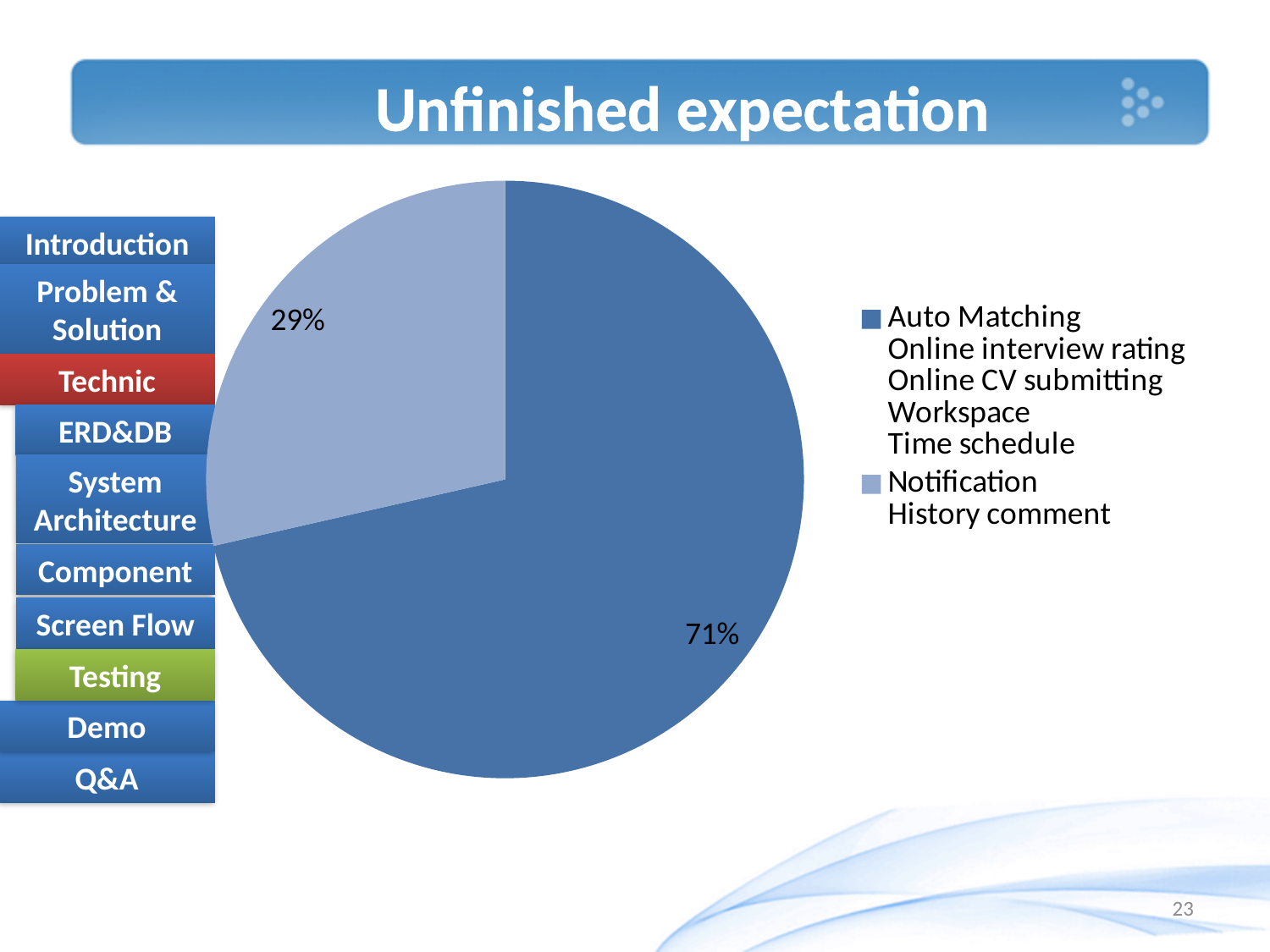
Which is larger: the slice for "Notification, History comment" or the slice for "Auto Matching, Online interview rating, Online CV submitting, Workspace, Time schedule"? Auto Matching, Online interview rating, Online CV submitting, Workspace, Time schedule What percentage is shown for the slice labelled "Auto Matching, Online interview rating, Online CV submitting, Workspace, Time schedule"? 71% Which slice of the pie chart is the smallest? Notification, History comment What share of the pie does the "Notification, History comment" slice take? 29% Which slice of the pie chart is drawn in the lighter blue colour? Notification, History comment What kind of chart is shown on the slide? pie chart What is the title shown at the top of the slide containing the pie chart? Unfinished expectation How many entries does the legend of the pie chart list? 2 What percentage is shown for the slice labelled "Notification, History comment"? 29% How many slices does the pie chart have? 2 Which slice of the pie chart is the largest? Auto Matching, Online interview rating, Online CV submitting, Workspace, Time schedule What is the difference in percentage points between the 71% slice and the 29% slice? 42